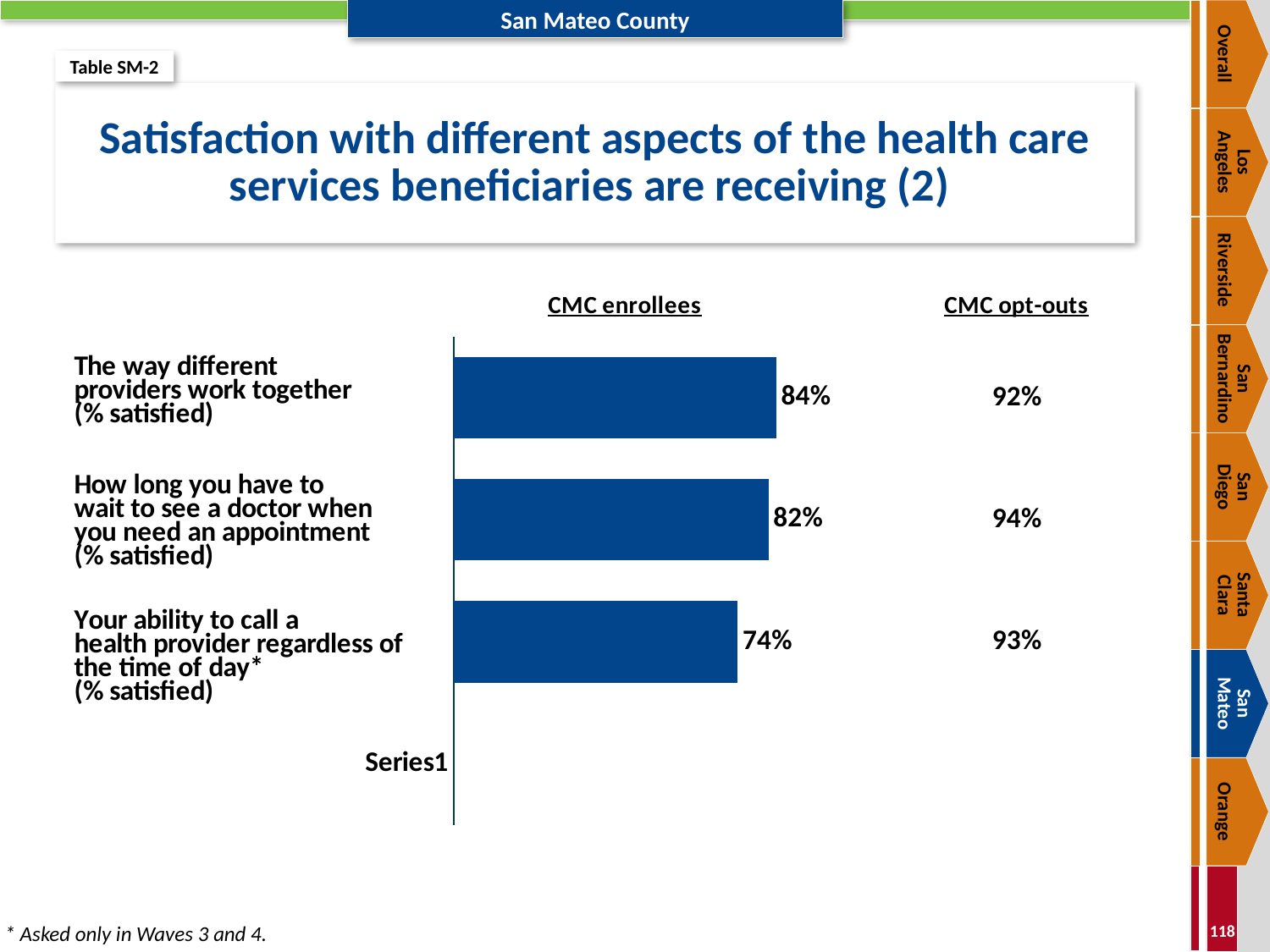
For 'The way different providers work together', which is larger: the CMC enrollees value or the CMC opt-outs value? CMC opt-outs What is the CMC enrollees value for 'How long you have to wait to see a doctor when you need an appointment (% satisfied)'? 82% How many categories are plotted as bars in the chart? 3 What is the CMC enrollees value for 'Your ability to call a health provider regardless of the time of day (% satisfied)'? 74% Which category has the lowest CMC enrollees value? Your ability to call a health provider regardless of the time of day (% satisfied) What is the difference between the CMC enrollees values for 'The way different providers work together' and 'Your ability to call a health provider regardless of the time of day'? 10% Which category has the highest CMC enrollees value? The way different providers work together (% satisfied) What is the title of the chart on the slide? Satisfaction with different aspects of the health care services beneficiaries are receiving (2) What is the CMC opt-outs value for 'How long you have to wait to see a doctor when you need an appointment (% satisfied)'? 94% What type of chart is shown on the slide? Bar chart What is the CMC enrollees value for 'The way different providers work together (% satisfied)'? 84% What is the difference between the CMC opt-outs and CMC enrollees values for 'Your ability to call a health provider regardless of the time of day'? 19%